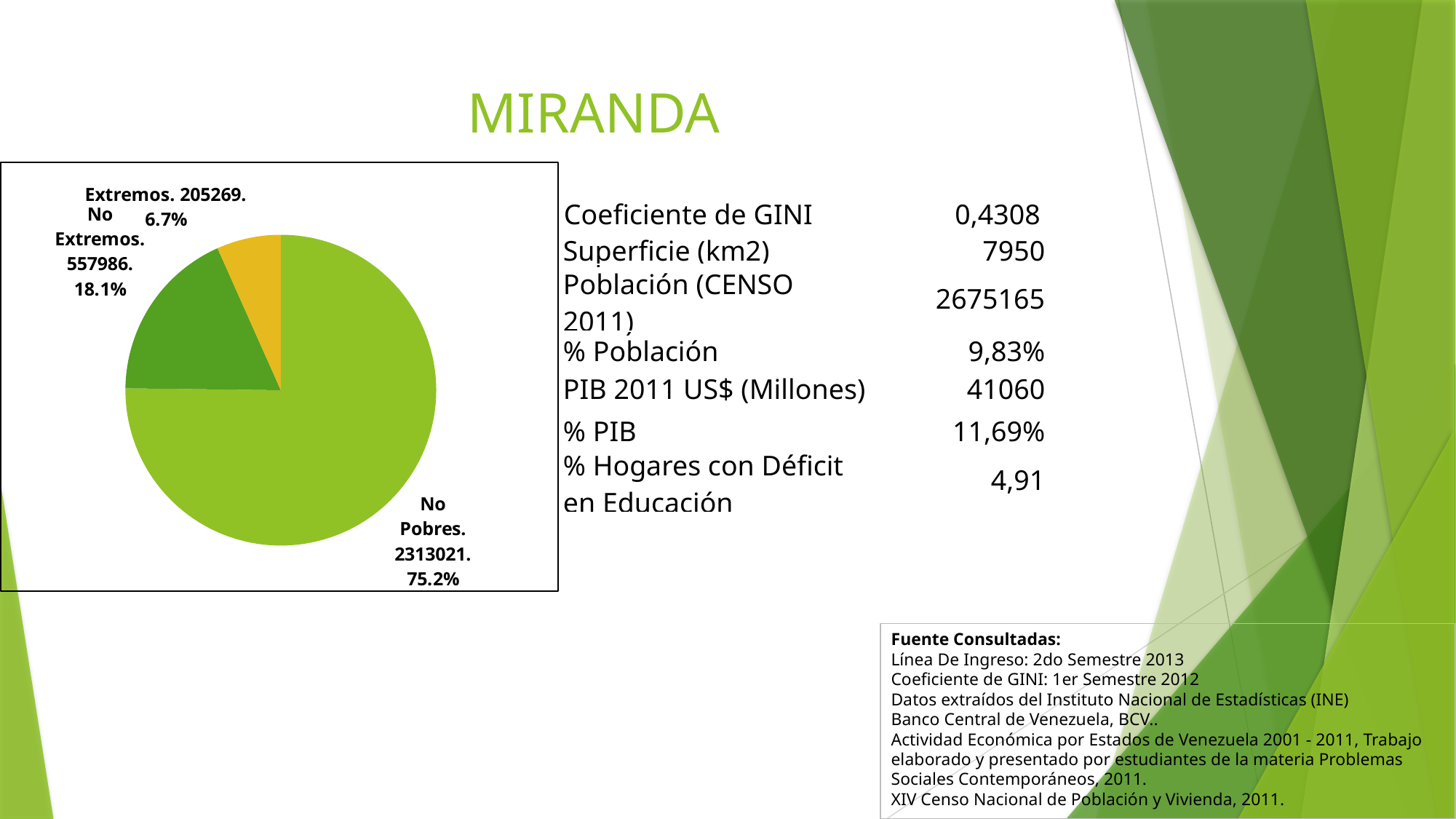
Which slice of the pie chart is the smallest? Extremos What percentage share of the pie does the No Pobres slice represent? 75.2% Which slice of the pie chart is the largest? No Pobres What is the value shown for the No Extremos slice of the pie chart? 557986 What percentage share of the pie does the Extremos slice represent? 6.7% What is the value shown for the Extremos slice of the pie chart? 205269 What is the value shown for the No Pobres slice of the pie chart? 2313021 Which is larger in the pie chart, No Extremos or Extremos? No Extremos How many slices does the pie chart have? 3 What kind of chart is shown on the slide? pie chart What is the difference between the No Extremos value and the Extremos value in the pie chart? 352717 What percentage share of the pie does the No Extremos slice represent? 18.1%